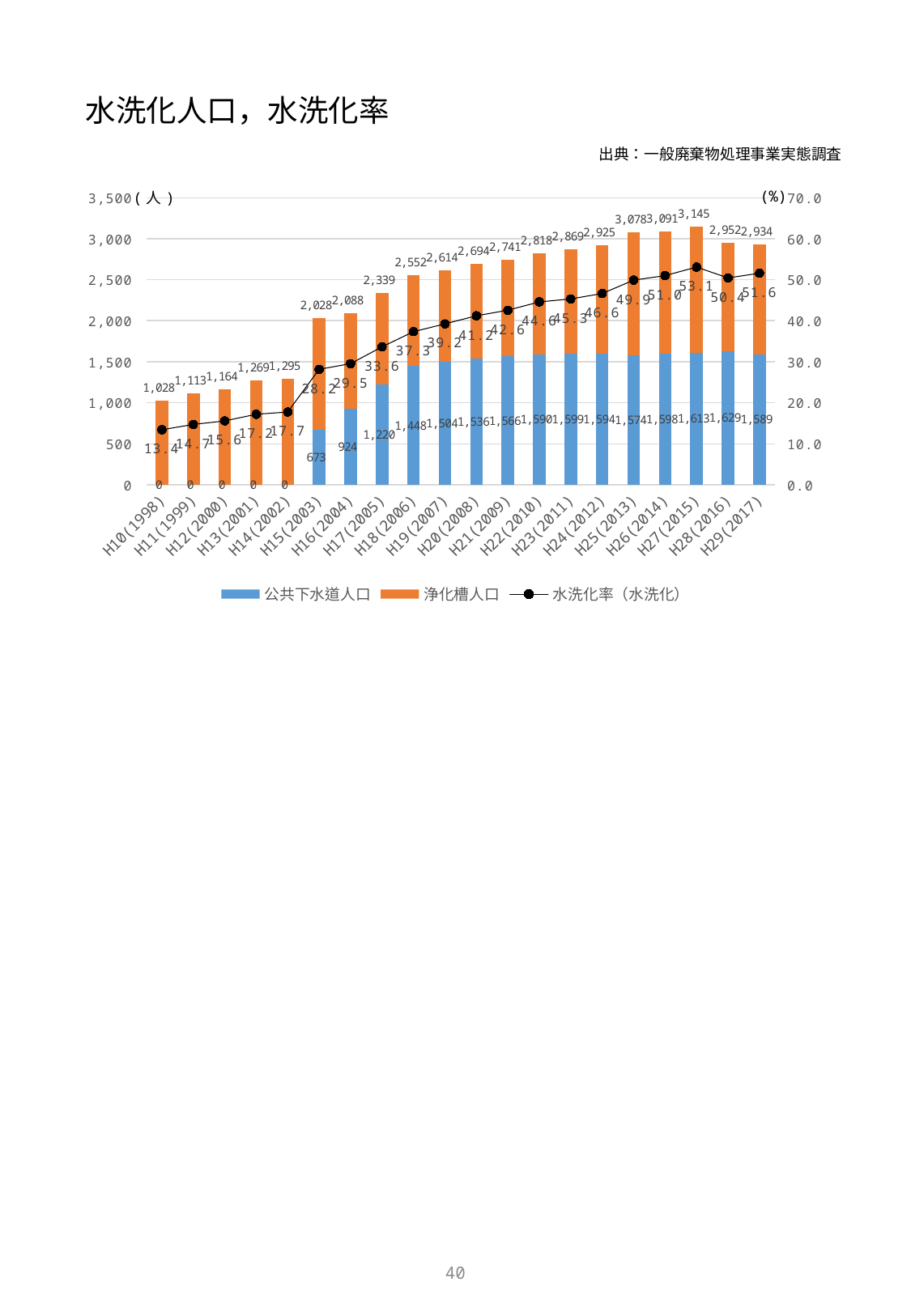
What is the difference between the 水洗化率（水洗化） values for H29(2017) and H10(1998)? 38.2 How many series does the legend list? 3 What source is cited for the chart? 一般廃棄物処理事業実態調査 What is the 水洗化率（水洗化） value for H20(2008)? 41.2 In which year is the 水洗化率（水洗化） line at its highest? H27(2015) How many years (categories) are shown on the x axis? 20 Which year has the larger 公共下水道人口 value, H17(2005) or H18(2006)? H18(2006) In which year is the 水洗化率（水洗化） line at its lowest? H10(1998) What value is labelled at the top of the bar for H27(2015)? 3,145 What is the value of 公共下水道人口 for H17(2005)? 1,220 What kind of chart is shown on the slide? A bar chart combined with a line chart Does the 水洗化率（水洗化） line generally rise or fall from H10(1998) to H29(2017)? Rise